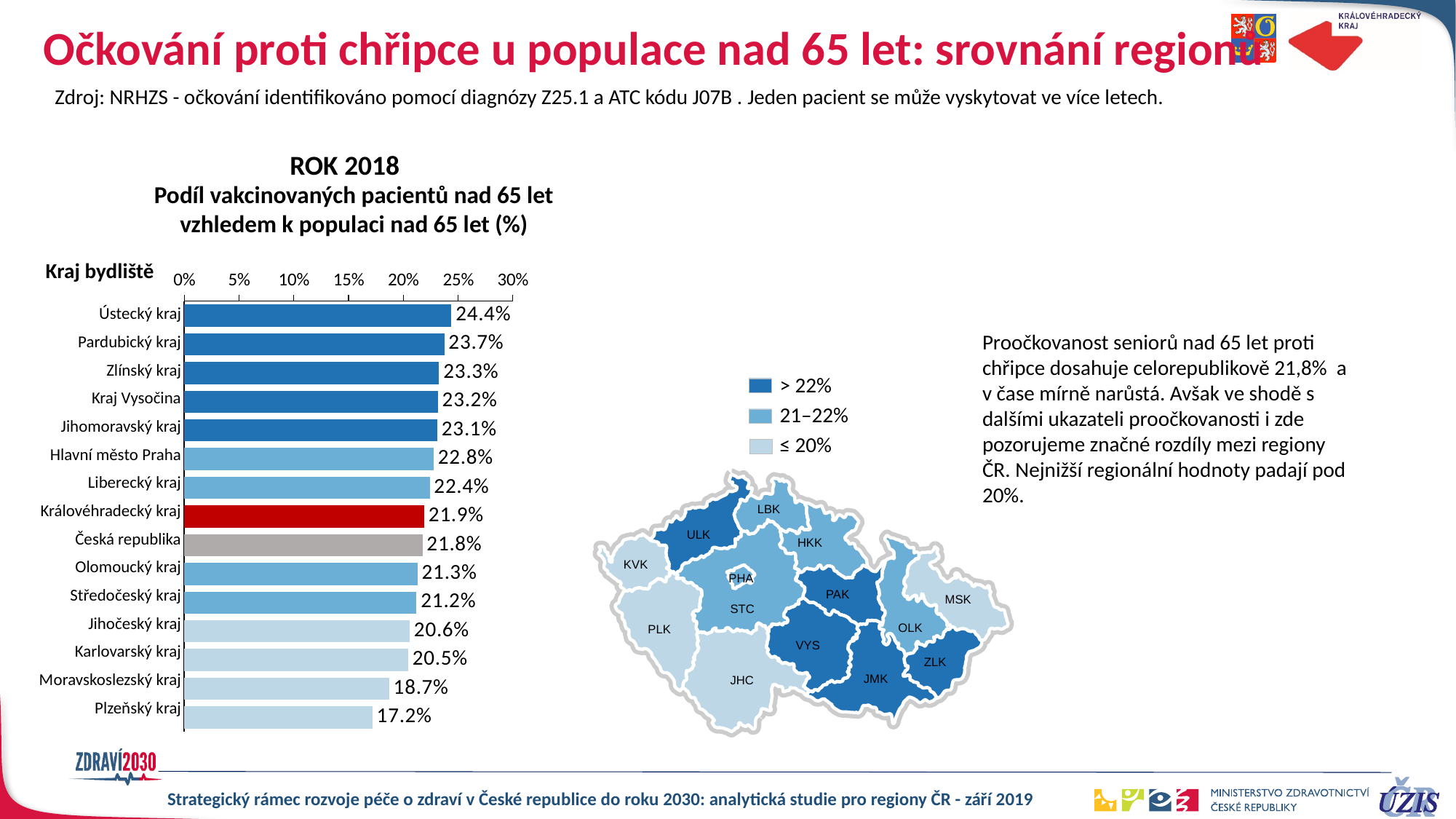
Which region has the highest value? Ústecký kraj What is the value for Moravskoslezský kraj? 18.7% What is the value for Hlavní město Praha? 22.8% Is the value for Karlovarský kraj greater or less than 25%? less What colour is the bar for Královéhradecký kraj? red Which region has the lowest value? Plzeňský kraj What is the value for Královéhradecký kraj? 21.9% What kind of chart is shown on the slide? bar chart How many bars are plotted in the chart? 15 Which is larger, the value for Liberecký kraj or the value for Olomoucký kraj? Liberecký kraj What is the value for Česká republika? 21.8% What is the difference between the values for Ústecký kraj and Plzeňský kraj? 7.2 percentage points